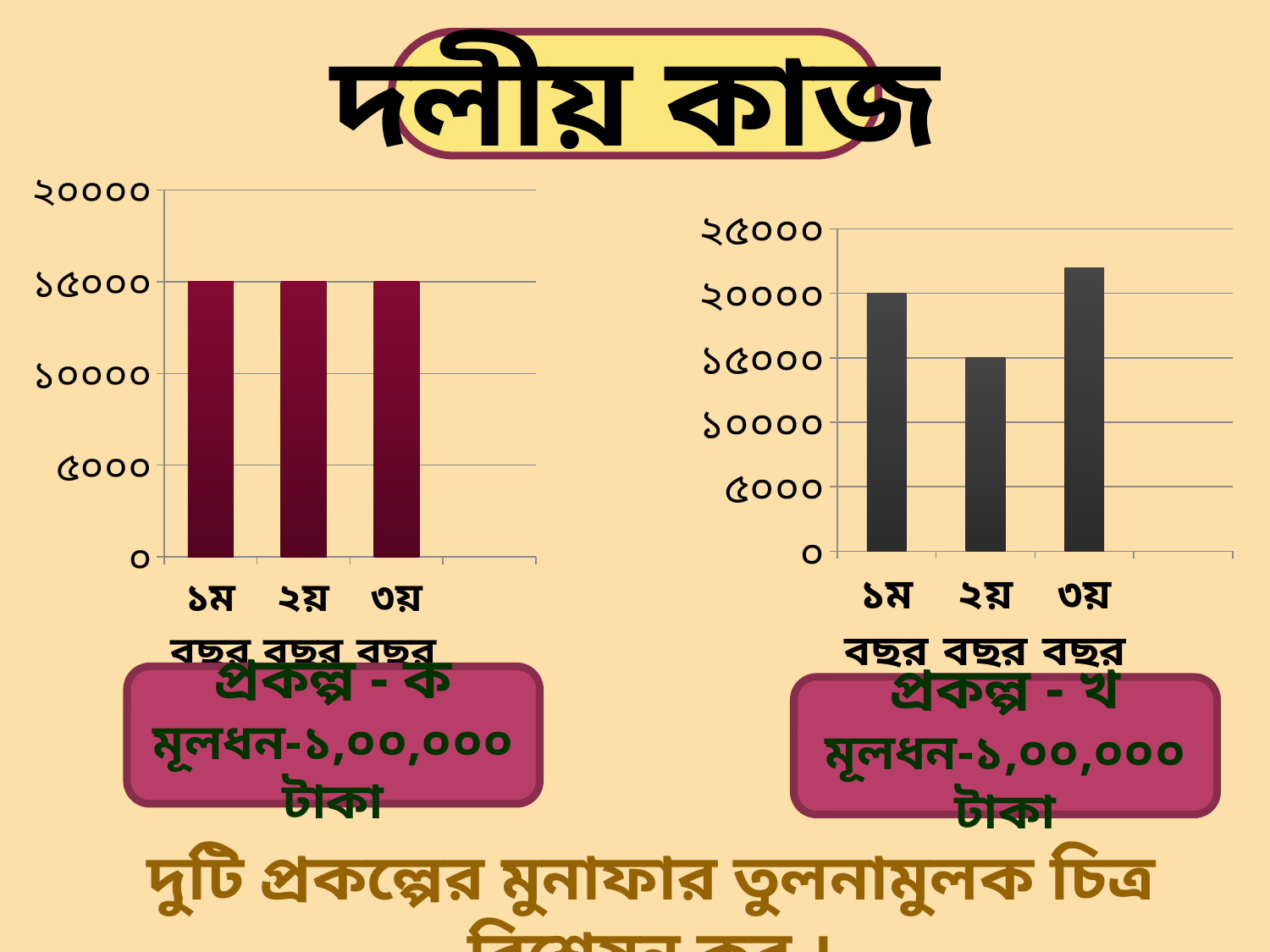
In the right chart (প্রকল্প - খ), what is the value for ২য় বছর? ১৫০০০ How many bars does the left chart (প্রকল্প - ক) show? 3 In the right chart (প্রকল্প - খ), which year has the lowest value? ২য় বছর In the right chart (প্রকল্প - খ), is the value for ৩য় বছর greater or less than ২০০০০? greater In the right chart (প্রকল্প - খ), which is larger: the value for ১ম বছর or ২য় বছর? ১ম বছর In the left chart (প্রকল্প - ক), do the values rise, fall or stay the same from ১ম বছর to ৩য় বছর? stay the same In the left chart (প্রকল্প - ক), what is the value for ১ম বছর? ১৫০০০ In the right chart (প্রকল্প - খ), what is the difference between the values for ১ম বছর and ২য় বছর? ৫০০০ What project label appears in the box below the left chart? প্রকল্প - ক What kind of chart is the left chart (প্রকল্প - ক)? bar chart In the right chart (প্রকল্প - খ), what is the value for ১ম বছর? ২০০০০ In the right chart (প্রকল্প - খ), which year has the highest value? ৩য় বছর